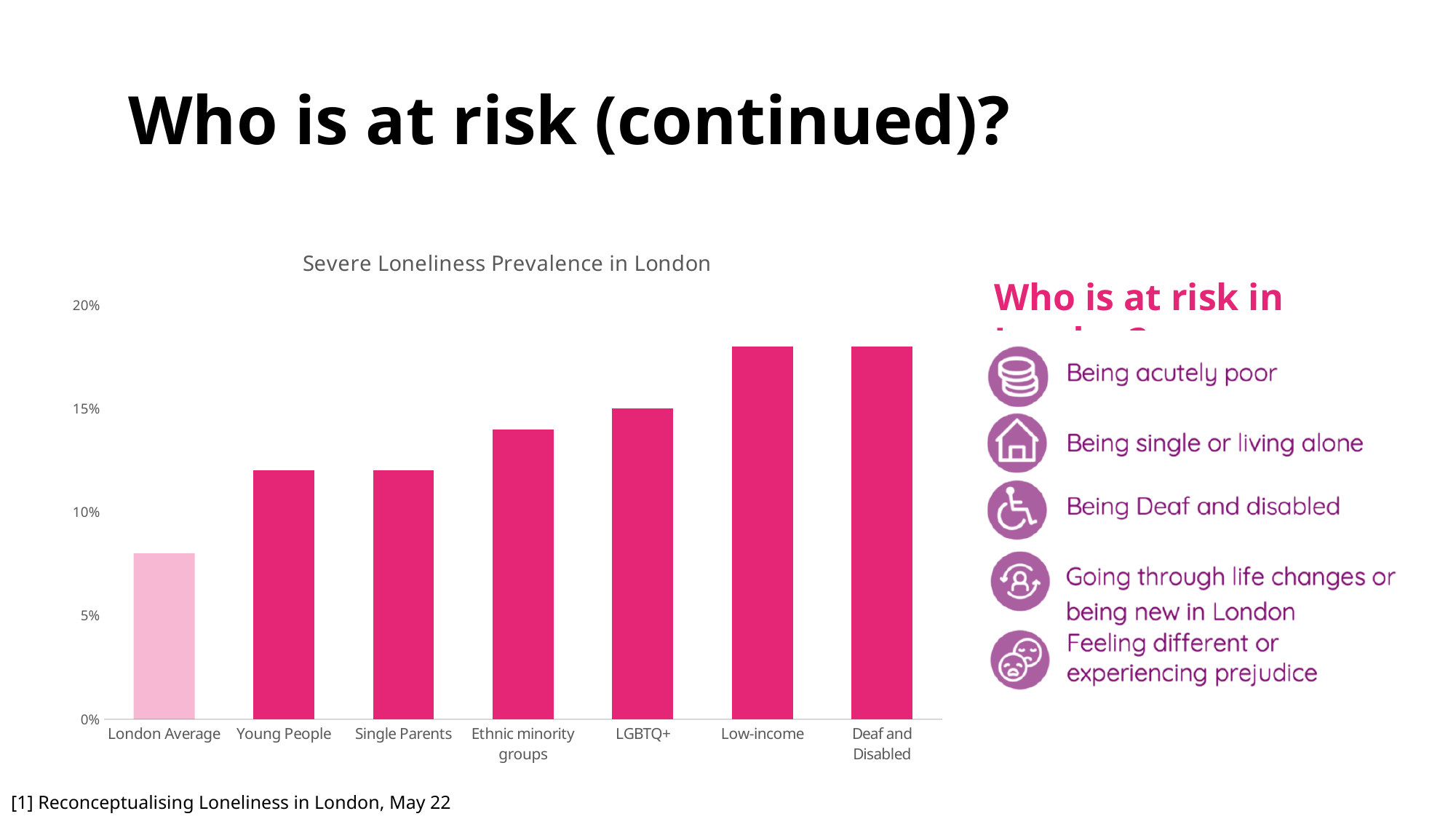
Which bar is drawn in a lighter shade of pink than the others? London Average What is the severe loneliness prevalence for LGBTQ+? 15% What is the title of the chart? Severe Loneliness Prevalence in London Is the value for Ethnic minority groups greater or less than 15%? less Do the values generally rise or fall from left to right across the categories? rise What kind of chart is shown on the slide? bar chart How many categories are plotted in the chart? 7 Is the value for London Average greater or less than 10%? less Which is larger, the value for Low-income or the value for Young People? Low-income Is the value for Young People greater or less than 10%? greater Which category has the lowest severe loneliness prevalence? London Average